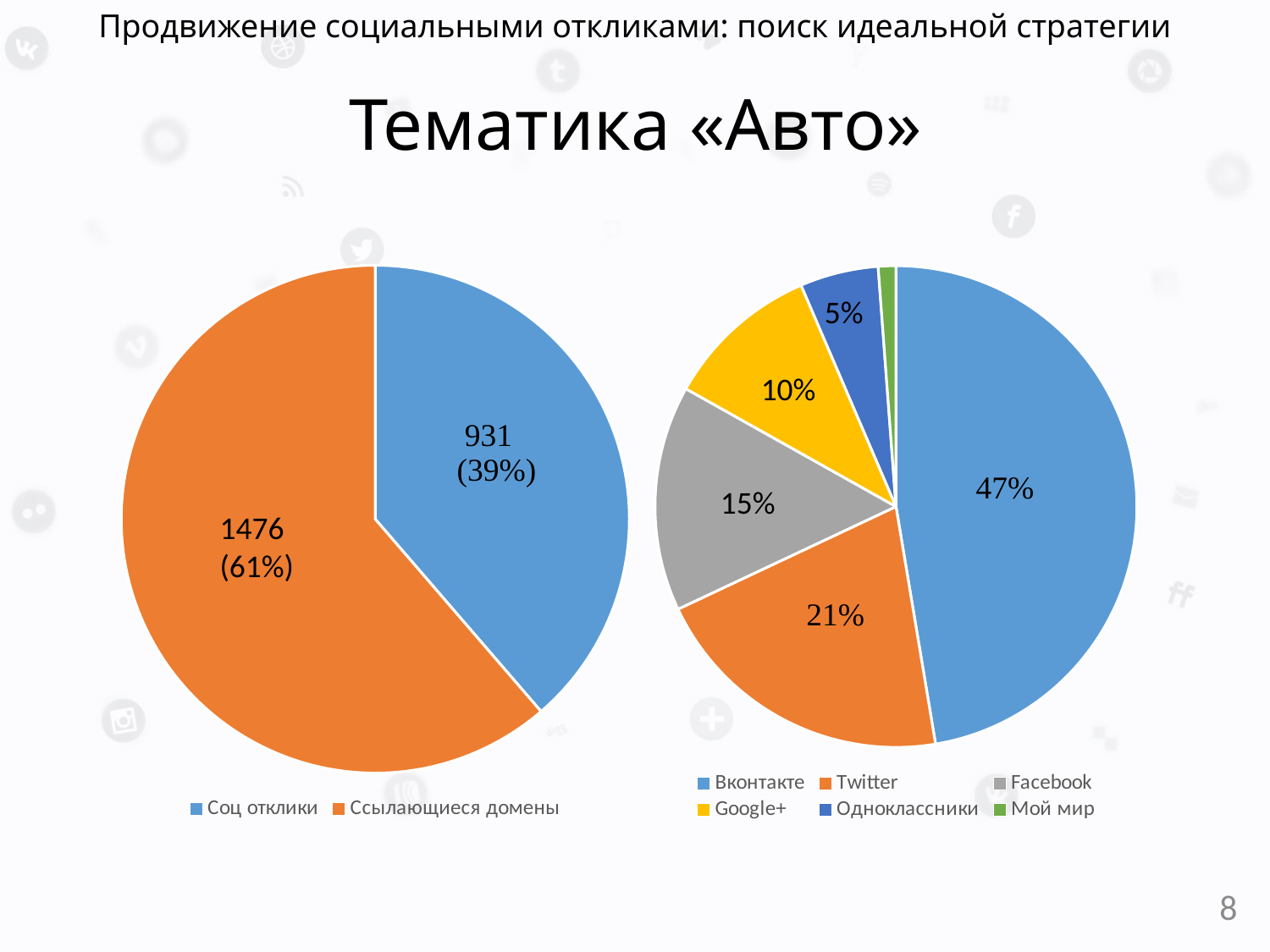
In the left pie chart, what is the value for Соц отклики? 931 In the left pie chart, what is the value for Ссылающиеся домены? 1476 In the left pie chart, what share of the pie does Ссылающиеся домены take? 61% In the right pie chart, what share does Вконтакте have? 47% In the right pie chart, what share does Google+ have? 10% How many categories does the legend of the right pie chart list? 6 In the left pie chart, which category is larger: Соц отклики or Ссылающиеся домены? Ссылающиеся домены In the left pie chart, what is the difference between the values for Ссылающиеся домены and Соц отклики? 545 In the right pie chart, which category has the largest share? Вконтакте In the right pie chart, which category has the smallest share? Мой мир In the right pie chart, what share does Facebook have? 15% What type of chart is the left chart on the slide? Pie chart